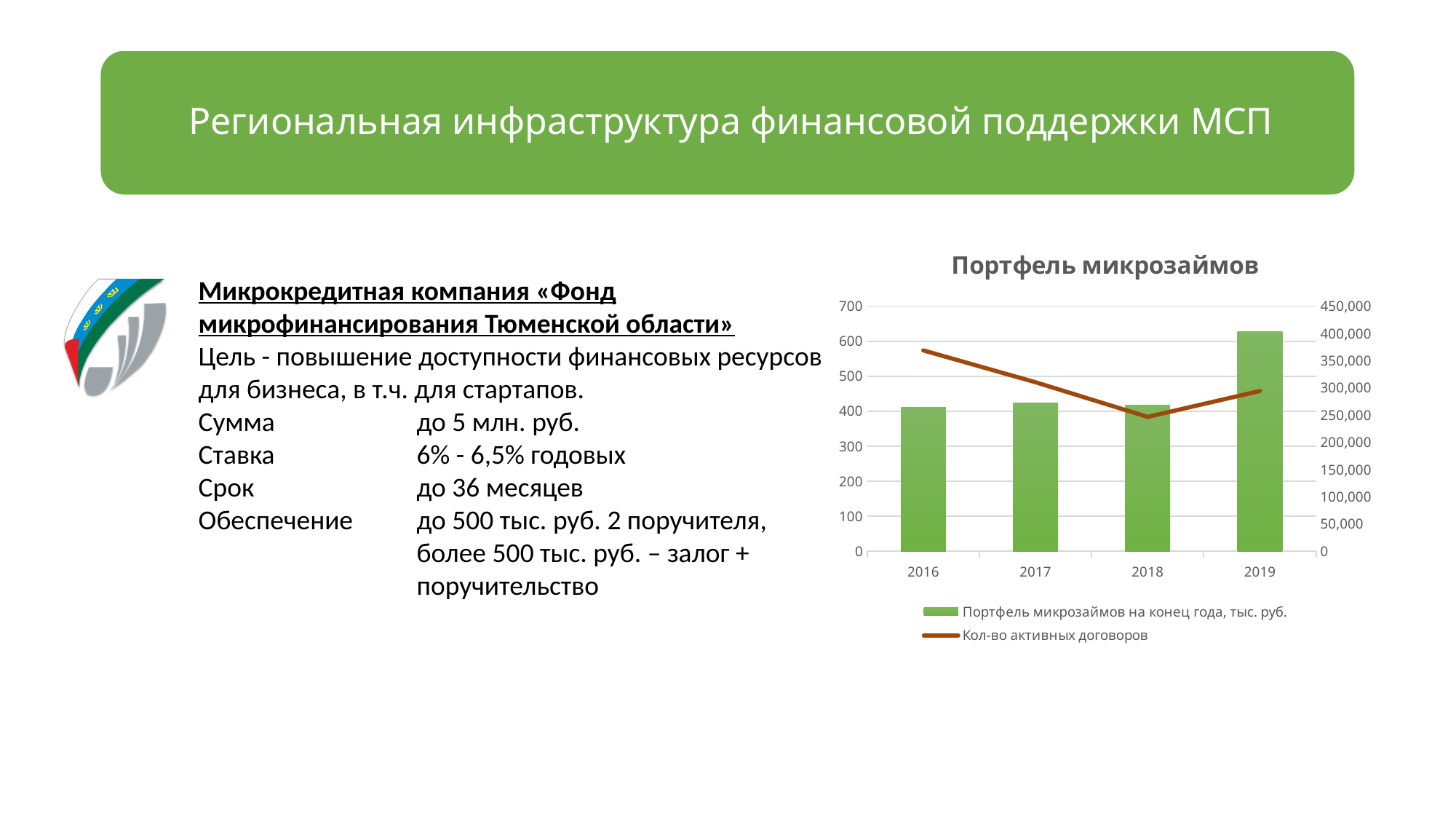
In which year is the line 'Кол-во активных договоров' at its highest point? 2016 How many series does the chart legend list? 2 Which year has the highest bar for 'Портфель микрозаймов на конец года, тыс. руб.'? 2019 Which bar is taller, 2019 or 2017? 2019 Does the line 'Кол-во активных договоров' rise or fall from 2016 to 2018? fall How many years are shown on the x axis of the chart? 4 In which year is the line 'Кол-во активных договоров' at its lowest point? 2018 What is the title of the chart? Портфель микрозаймов What kind of chart is shown on the slide? A combined bar and line chart